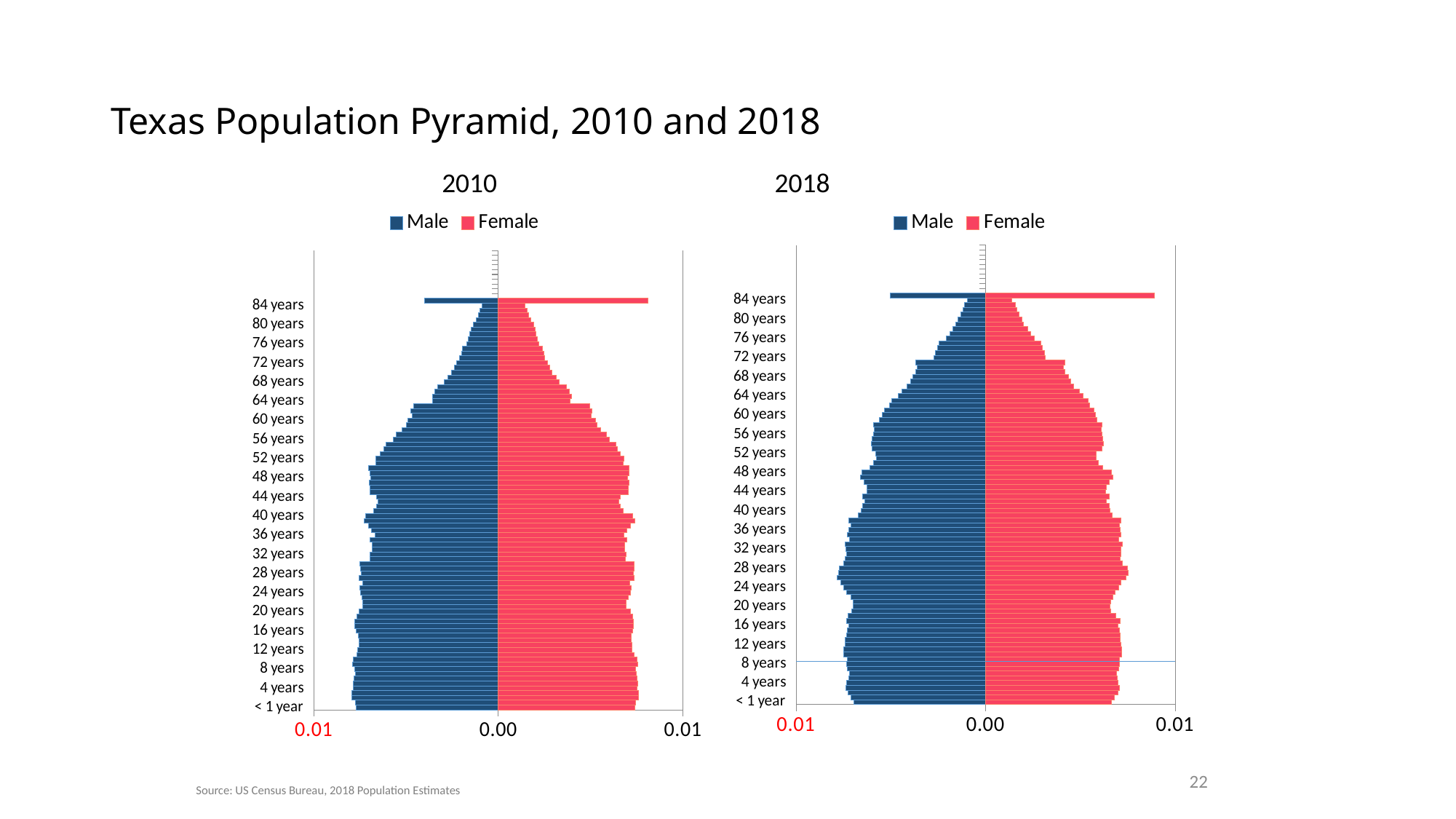
In the 2018 chart, which is longer: the Female bar for 28 years or the Female bar for 72 years? 28 years What is the title of the slide? Texas Population Pyramid, 2010 and 2018 In the 2018 chart, which is longer: the Male bar for 76 years or the Male bar for 60 years? 60 years What kind of chart is the 2010 chart? bar chart How many series does the legend of the 2018 chart list? 2 In the 2010 chart, which series is shown in dark blue? Male In the 2018 chart, is the Female value for 84 years greater or less than 0.01? less